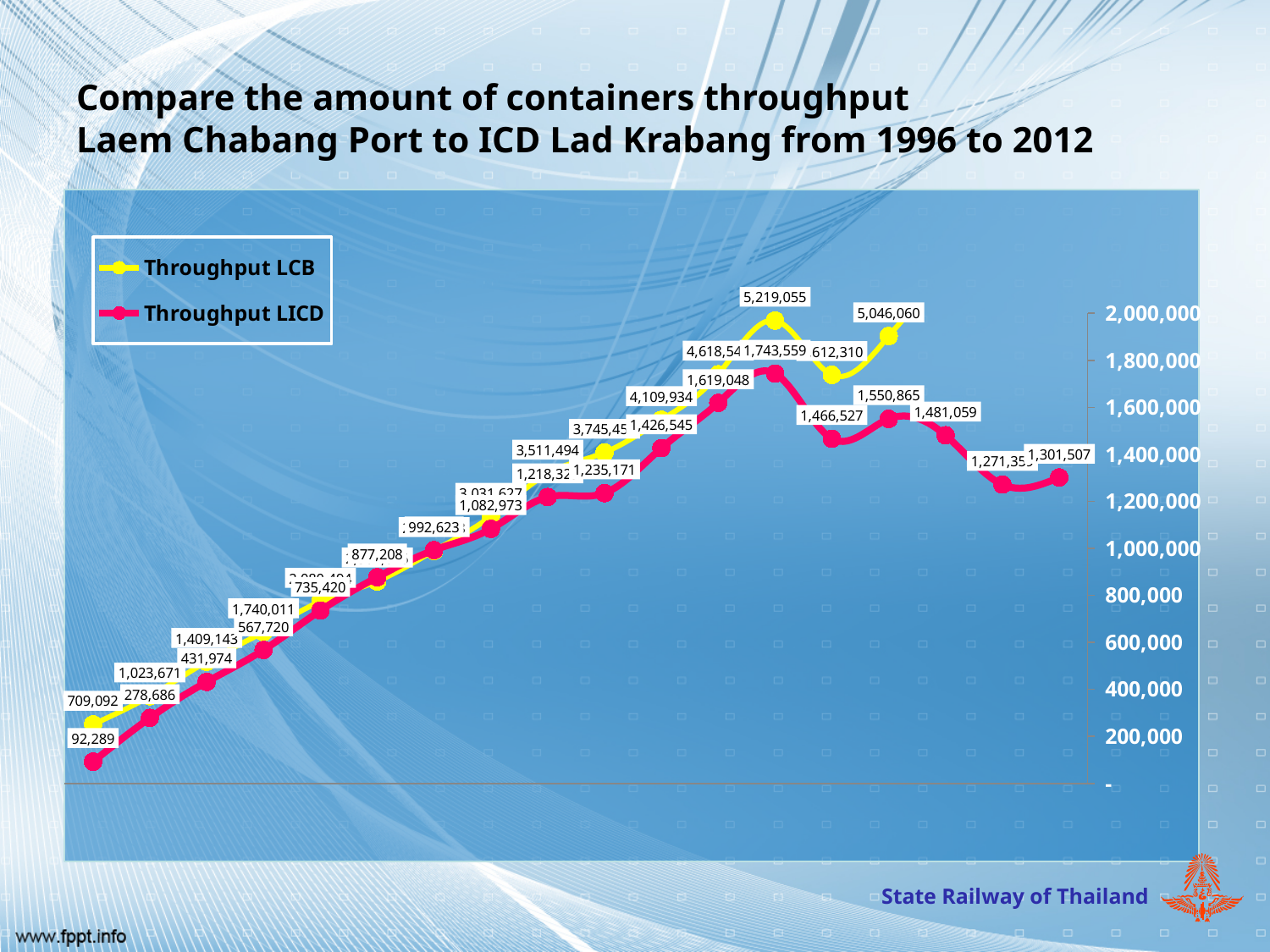
Which series has the higher first value: Throughput LCB (709,092) or Throughput LICD (92,289)? Throughput LCB What are the two series named in the legend? Throughput LCB and Throughput LICD What is the difference between the peak Throughput LCB value (5,219,055) and its last value (5,046,060)? 172,995 How many series does the legend list? 2 What is the lowest value labelled on the Throughput LICD series? 92,289 What is the highest value labelled on the Throughput LCB series? 5,219,055 What is the last (rightmost) value labelled on the Throughput LICD series? 1,301,507 What is the last (rightmost) value labelled on the Throughput LCB series? 5,046,060 What kind of chart is shown on the slide? Line chart What is the lowest value labelled on the Throughput LCB series? 709,092 What is the highest value labelled on the Throughput LICD series? 1,743,559 What colour is the Throughput LCB line? Yellow